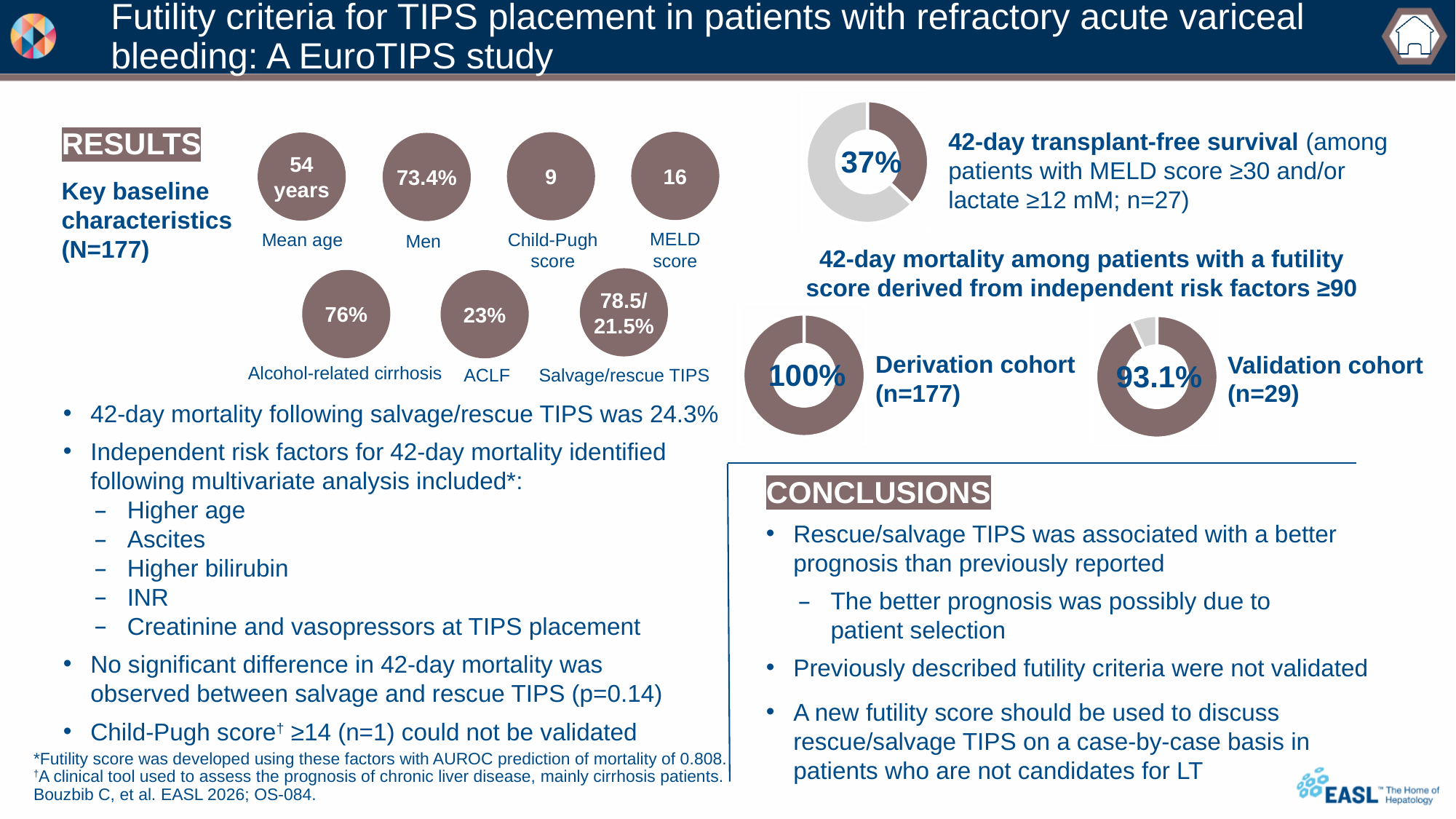
In the 42-day mortality charts, what is the value for the derivation cohort? 100% What is the sample size (n) of the derivation cohort shown next to its donut chart? n=177 Is the validation cohort 42-day mortality value greater or less than 90%? greater Is the 42-day transplant-free survival value greater or less than 50%? less What value is shown in the 42-day transplant-free survival donut chart? 37% What kind of chart is used to show the 42-day transplant-free survival? Donut (pie) chart In the 42-day mortality charts, what is the value for the validation cohort? 93.1% What is the sample size (n) of the validation cohort shown next to its donut chart? n=29 Which cohort shows the higher 42-day mortality, the derivation cohort or the validation cohort? Derivation cohort What is the difference between the 42-day mortality values of the derivation cohort and the validation cohort? 6.9% How many donut charts are shown on the slide? 3 What share of the 42-day transplant-free survival donut is filled by the highlighted segment? 37%